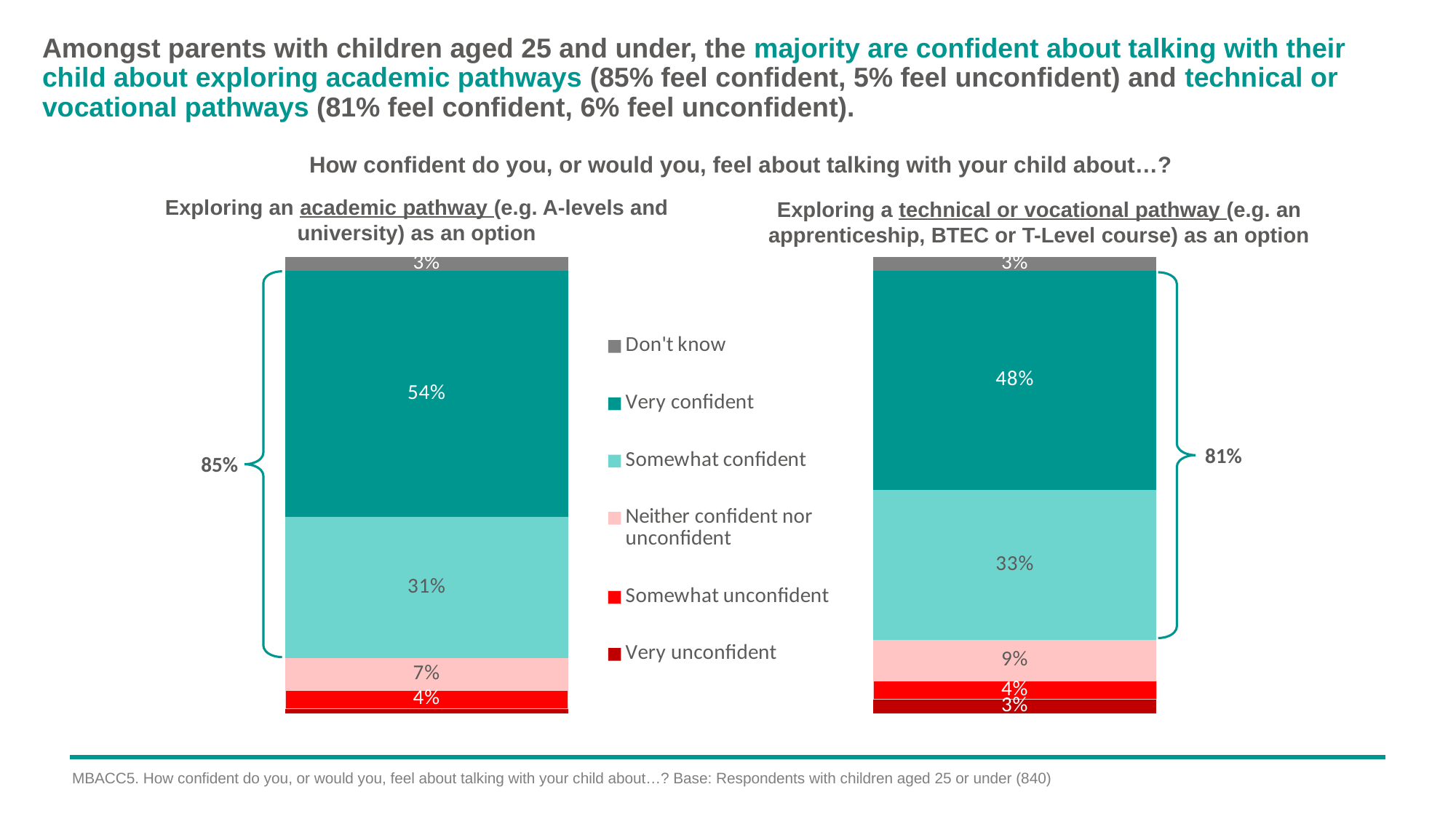
What combined confident percentage does the bracket show for the 'Exploring an academic pathway' chart? 85% How many percentage points higher is the 'Very confident' share in the academic pathway chart than in the technical or vocational pathway chart? 6 percentage points In the 'Exploring a technical or vocational pathway' chart, what percentage of parents answered 'Don't know'? 3% In the 'Exploring an academic pathway' chart, which response has the largest share? Very confident In the 'Exploring an academic pathway' chart, what percentage of parents are neither confident nor unconfident? 7% In the 'Exploring an academic pathway' chart, what percentage of parents are very confident? 54% In the 'Exploring a technical or vocational pathway' chart, what is the difference between the 'Very confident' and 'Somewhat confident' shares? 15 percentage points Is the 'Somewhat confident' share larger in the academic pathway chart or the technical or vocational pathway chart? Technical or vocational pathway How many response categories does the legend list? 6 In the 'Exploring a technical or vocational pathway' chart, what percentage of parents are somewhat confident? 33% What type of chart is used on this slide? Stacked bar chart In the 'Exploring a technical or vocational pathway' chart, what percentage of parents are very unconfident? 3%